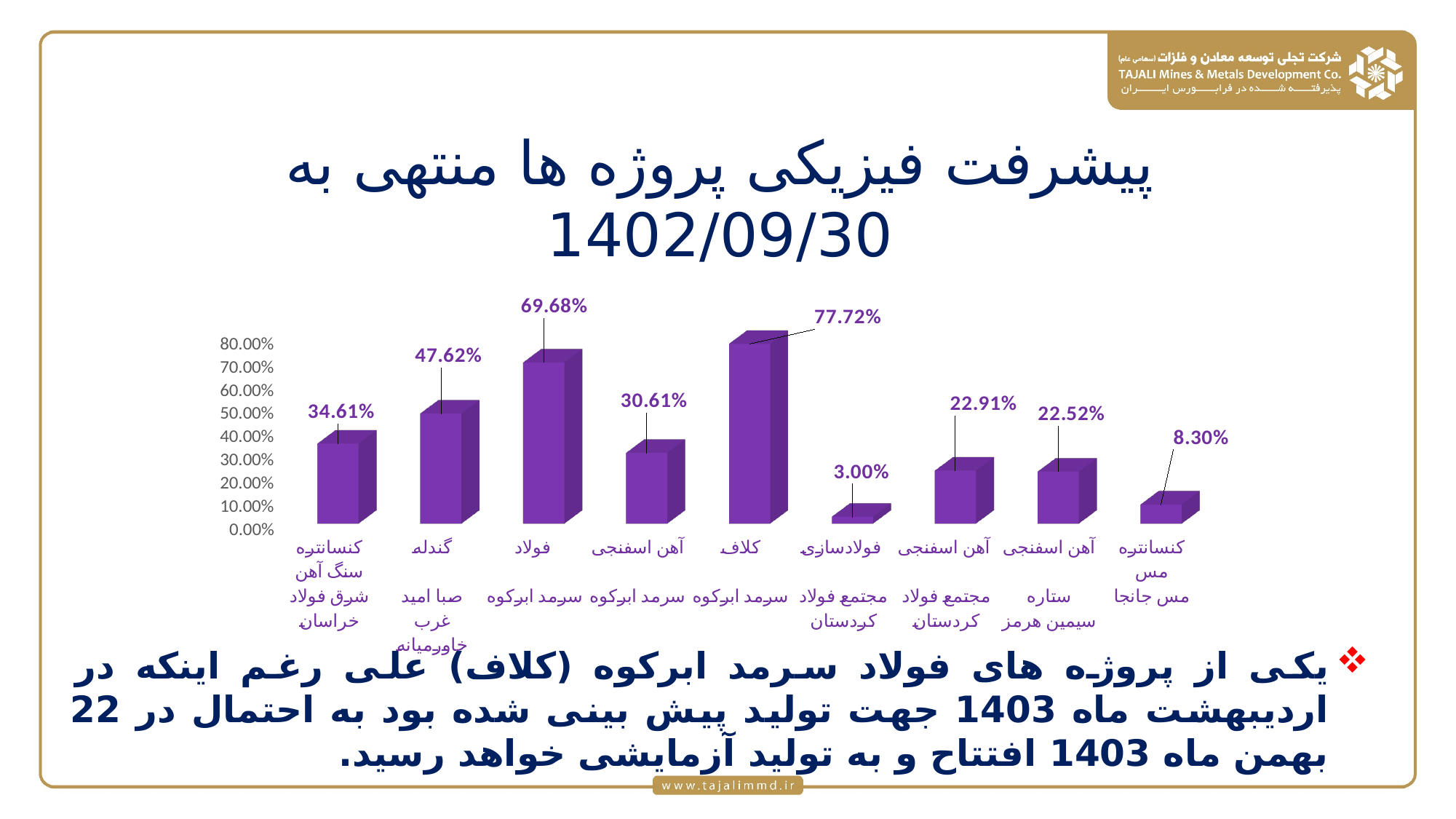
What is the difference between the values for کلاف سرمد ابرکوه and فولاد سرمد ابرکوه? 8.04% What is the value shown for کنسانتره مس مس جانجا? 8.30% Which project has the highest physical progress in the chart? کلاف سرمد ابرکوه Which is larger: the value for فولاد سرمد ابرکوه or the value for آهن اسفنجی سرمد ابرکوه? فولاد سرمد ابرکوه What type of chart is shown on the slide? Bar chart What is the difference between the values for گندله صبا امید غرب خاورمیانه and کنسانتره سنگ آهن شرق فولاد خراسان? 13.01% What is the title of the chart on the slide? پیشرفت فیزیکی پروژه ها منتهی به 1402/09/30 How many projects (bars) are shown in the chart? 9 What value is shown for آهن اسفنجی ستاره سیمین هرمز? 22.52% What value is labelled for گندله صبا امید غرب خاورمیانه? 47.62% What is the physical progress value shown for کلاف سرمد ابرکوه? 77.72% Which project has the lowest physical progress in the chart? فولادسازی مجتمع فولاد کردستان